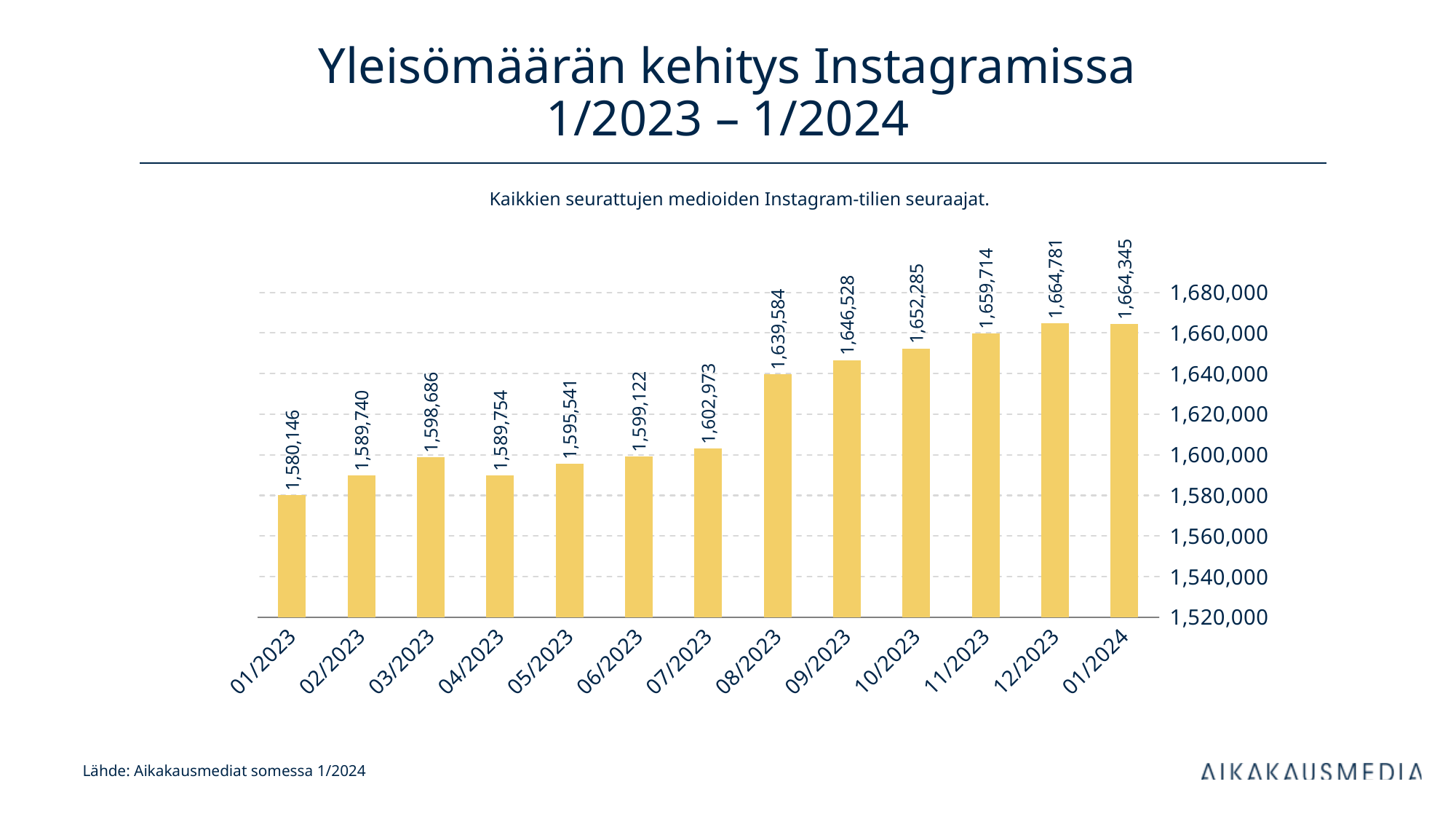
What is the value for 01/2024? 1,664,345 Which month has the highest value? 12/2023 Which month has the lowest value? 01/2023 Is the value for 07/2023 greater or less than 1,600,000? greater What kind of chart is shown on the slide? Bar chart How many months are shown on the x axis? 13 What is the value for 08/2023? 1,639,584 Which is larger, the value for 03/2023 or the value for 04/2023? 03/2023 What is the difference between the values for 01/2024 and 01/2023? 84,199 What is the difference between the values for 08/2023 and 07/2023? 36,611 What is the value for 04/2023? 1,589,754 Do the values generally rise or fall from 01/2023 to 01/2024? Rise